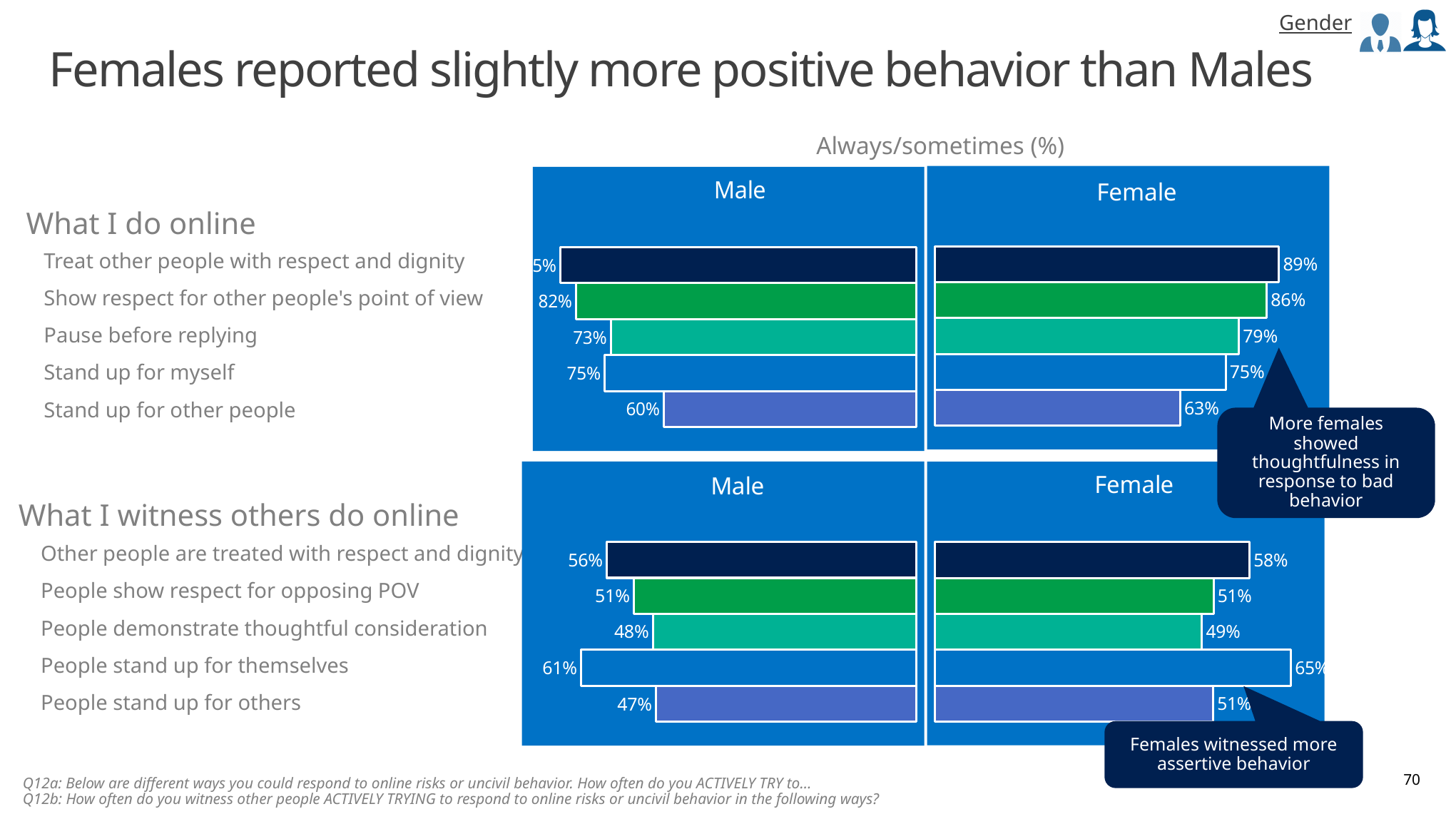
In the "What I do online" chart, what is the difference between the Female and Male percentages for "Pause before replying"? 6% In the "What I witness others do online" chart, what percentage of Males reported that people stand up for others? 47% In the "What I witness others do online" chart, what is the difference between the Female and Male percentages for "People stand up for themselves"? 4% In the "What I do online" chart, what percentage of Females reported they show respect for other people's point of view? 86% In the "What I do online" chart, which behavior has the highest percentage for Females? Treat other people with respect and dignity In the "What I do online" chart, what percentage of Males reported they pause before replying? 73% In the "What I witness others do online" chart, which behavior has the lowest percentage for Females? People demonstrate thoughtful consideration How many behaviors are listed in the "What I witness others do online" chart? 5 In the "What I witness others do online" chart, what percentage of Females reported that people stand up for themselves? 65% In the "What I do online" chart, which behavior has the lowest percentage for Males? Stand up for other people In the "What I witness others do online" chart, which behavior has the highest percentage for Males? People stand up for themselves In the "What I do online" chart, is the Male or Female percentage larger for "Stand up for other people"? Female